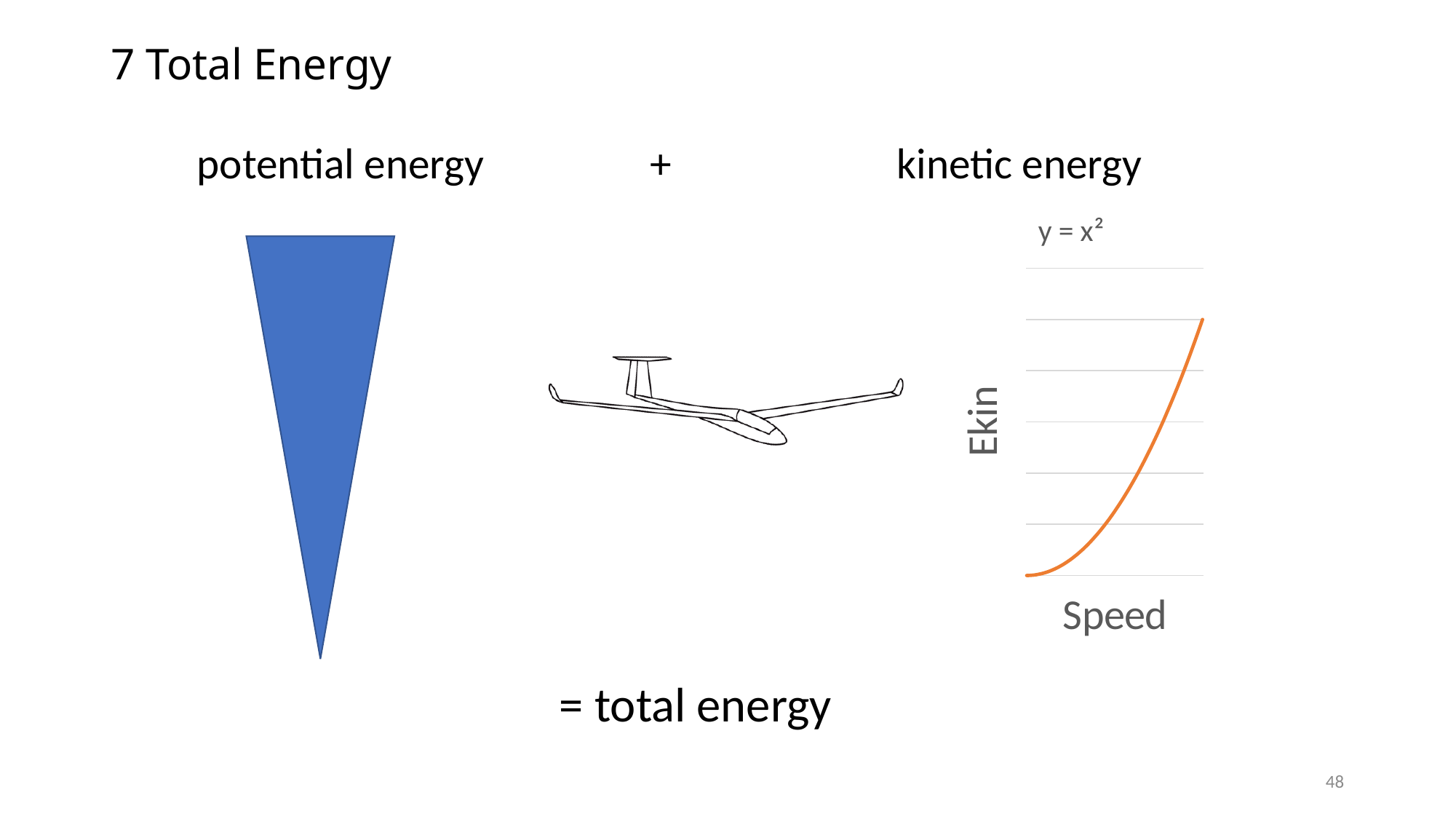
What is the label on the horizontal axis of the chart titled "y = x²"? Speed What kind of chart is shown under the heading "kinetic energy"? line chart What is the title of the chart on the right side of the slide? y = x² What is the label on the vertical axis of the chart titled "y = x²"? Ekin In the chart titled "y = x²", does the plotted line rise or fall as Speed increases? rise